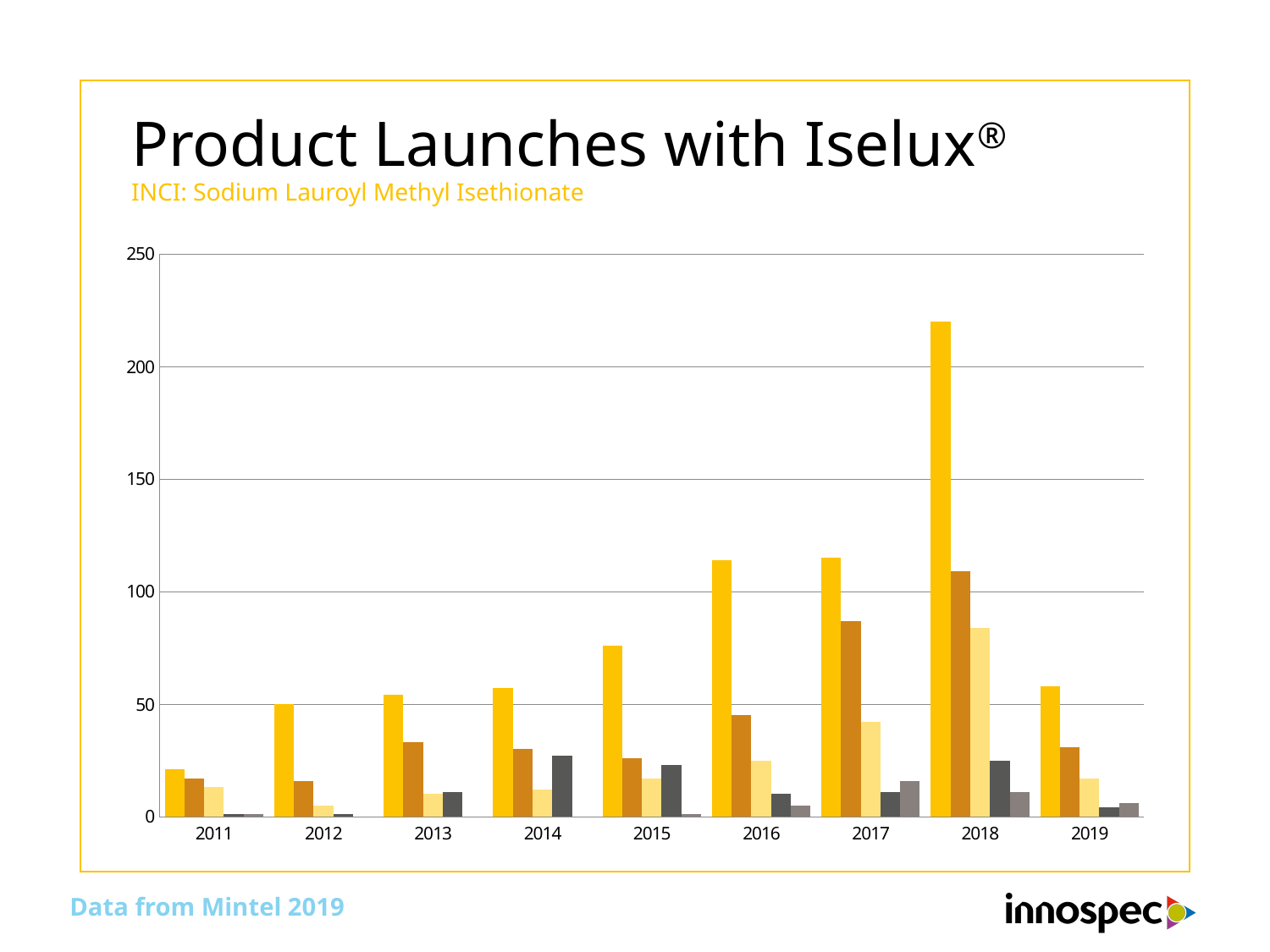
Do the yellow (first) bars generally rise or fall from 2011 to 2018? rise Which is larger: the yellow (first) bar for 2015 or the yellow (first) bar for 2019? 2015 Is the value of the yellow (first) bar for 2018 greater or less than 200? greater In which year is the yellow (first) bar the tallest? 2018 What is the title of the chart on the slide? Product Launches with Iselux® According to the note on the slide, where does the chart data come from? Mintel 2019 Is the value of the orange (second) bar for 2017 greater or less than 100? less Is the value of the yellow (first) bar for 2016 greater or less than 100? greater How many years are shown along the x axis of the chart? 9 What kind of chart is shown on the slide? bar chart In which year is the yellow (first) bar the shortest? 2011